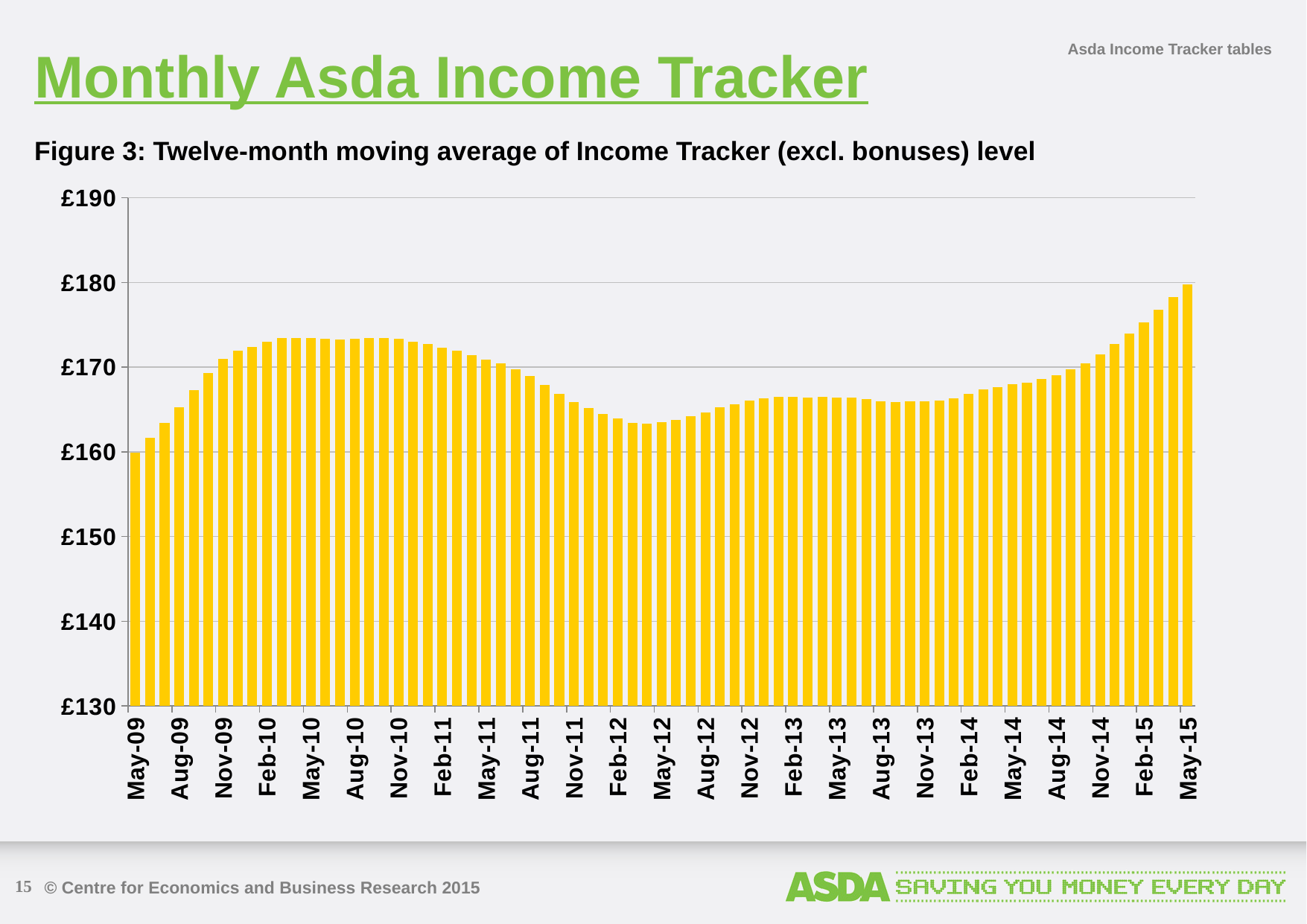
Do the values rise or fall from May-12 to May-15? rise What is the title of the figure shown on the slide? Figure 3: Twelve-month moving average of Income Tracker (excl. bonuses) level Is the value for Aug-09 greater or less than £170? less Which is larger, the value for Nov-14 or the value for Nov-13? Nov-14 Is the value for May-10 greater or less than £170? greater Which month has the lowest value in the chart? May-09 Is the value for Nov-14 greater or less than £170? greater Which month has the highest value in the chart? May-15 What kind of chart is shown on the slide? bar chart Which is larger, the value for Feb-10 or the value for Feb-12? Feb-10